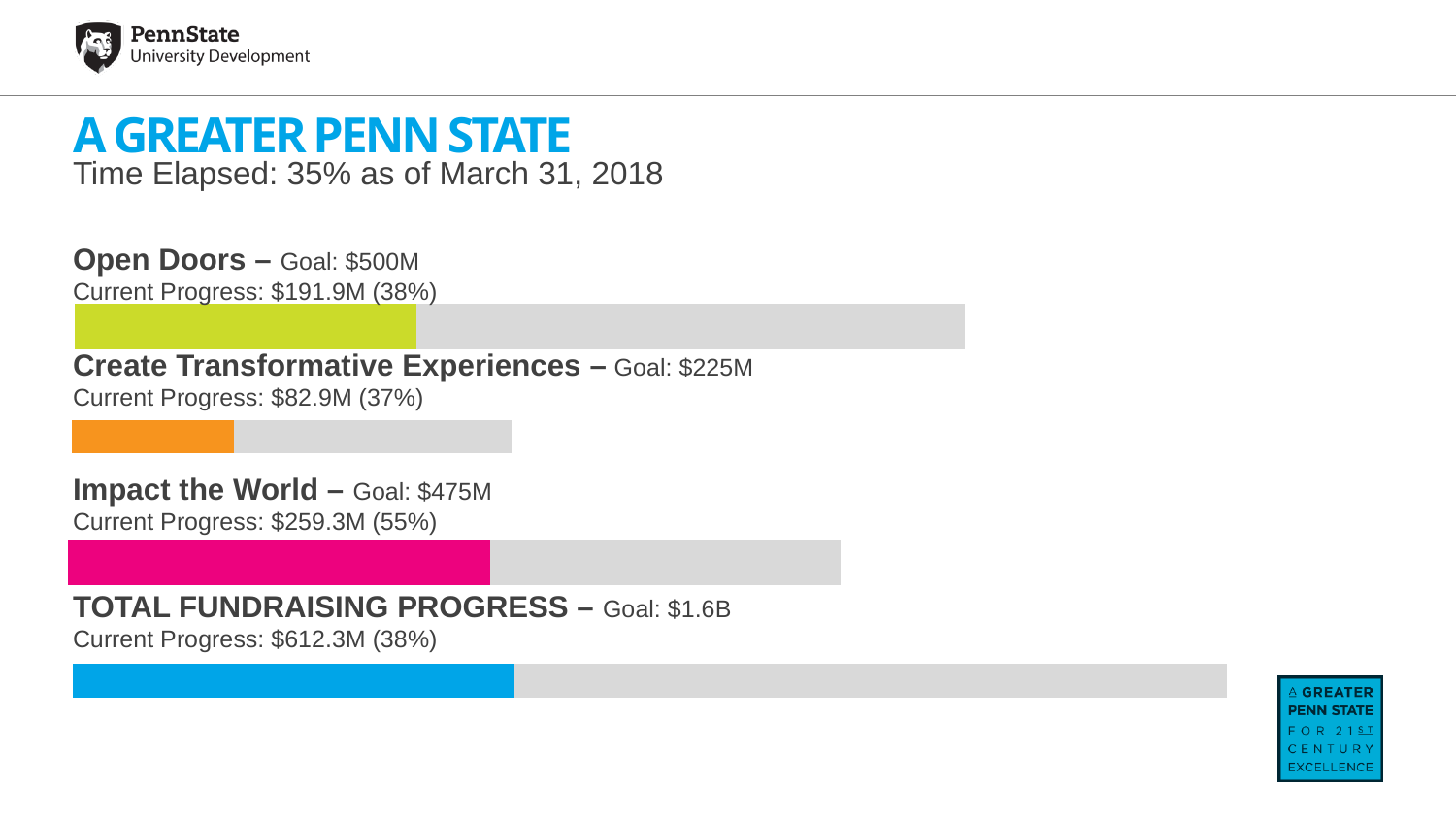
How many progress bars are shown on the slide? 4 What percentage of time has elapsed as of March 31, 2018? 35% What is the current progress for Open Doors? $191.9M (38%) What is the current progress for Impact the World? $259.3M (55%) What is the goal for Total Fundraising Progress? $1.6B What is the goal for Create Transformative Experiences? $225M What is the difference in current progress between Impact the World and Open Doors? $67.4M What colour is the progress bar for Impact the World? Pink What kind of chart is used to show the fundraising progress? Bar chart Which of the three priority areas has the lowest current progress in dollars? Create Transformative Experiences Which of the three priority areas (Open Doors, Create Transformative Experiences, Impact the World) has the highest percentage of its goal reached? Impact the World Which has a larger goal, Open Doors or Impact the World? Open Doors